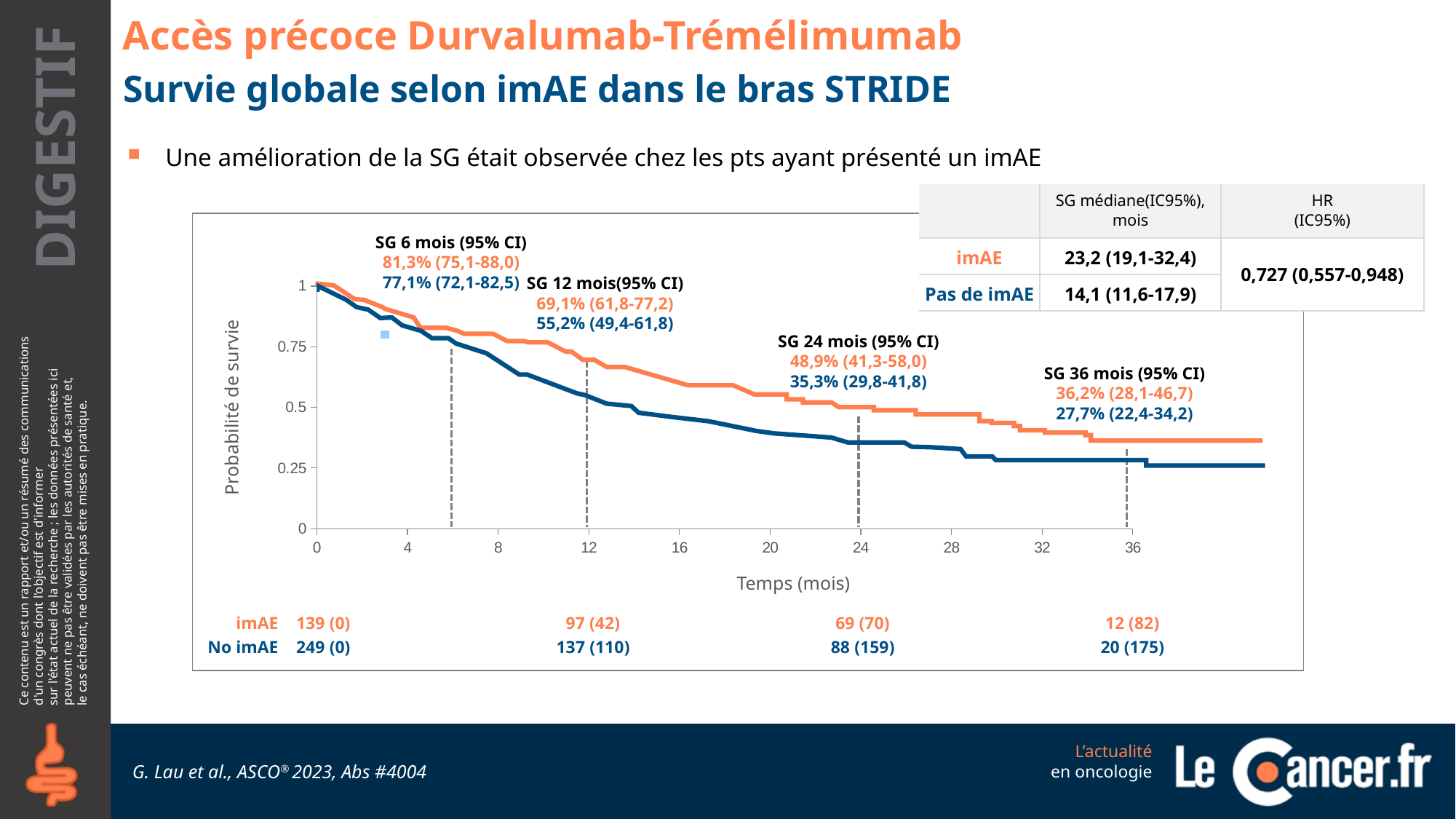
What is the difference in 24-month survival rate between the imAE group (48,9%) and the no-imAE group (35,3%)? 13,6 percentage points What is the hazard ratio (HR) shown in the table? 0,727 (0,557-0,948) How many survival curves (groups) are plotted on the chart? 2 At 20 months, is the survival probability of the No imAE (blue) curve greater or less than 0.5? less What is the 6-month overall survival rate (SG 6 mois) for the imAE group? 81,3% (75,1-88,0) At 20 months, is the survival probability of the imAE (orange) curve greater or less than 0.5? greater What is the difference in median overall survival between the imAE group (23,2 months) and the no-imAE group (14,1 months)? 9,1 months What kind of chart is shown on the slide? Line chart (Kaplan-Meier survival curve) What is the 12-month overall survival rate (SG 12 mois) for the group without imAE? 55,2% (49,4-61,8) Which group has the higher 36-month survival rate, imAE or Pas de imAE? imAE How many patients in the imAE group were at risk at 24 months, according to the numbers below the chart? 69 (70) What is the median overall survival (SG médiane) for the imAE group, in months? 23,2 (19,1-32,4)